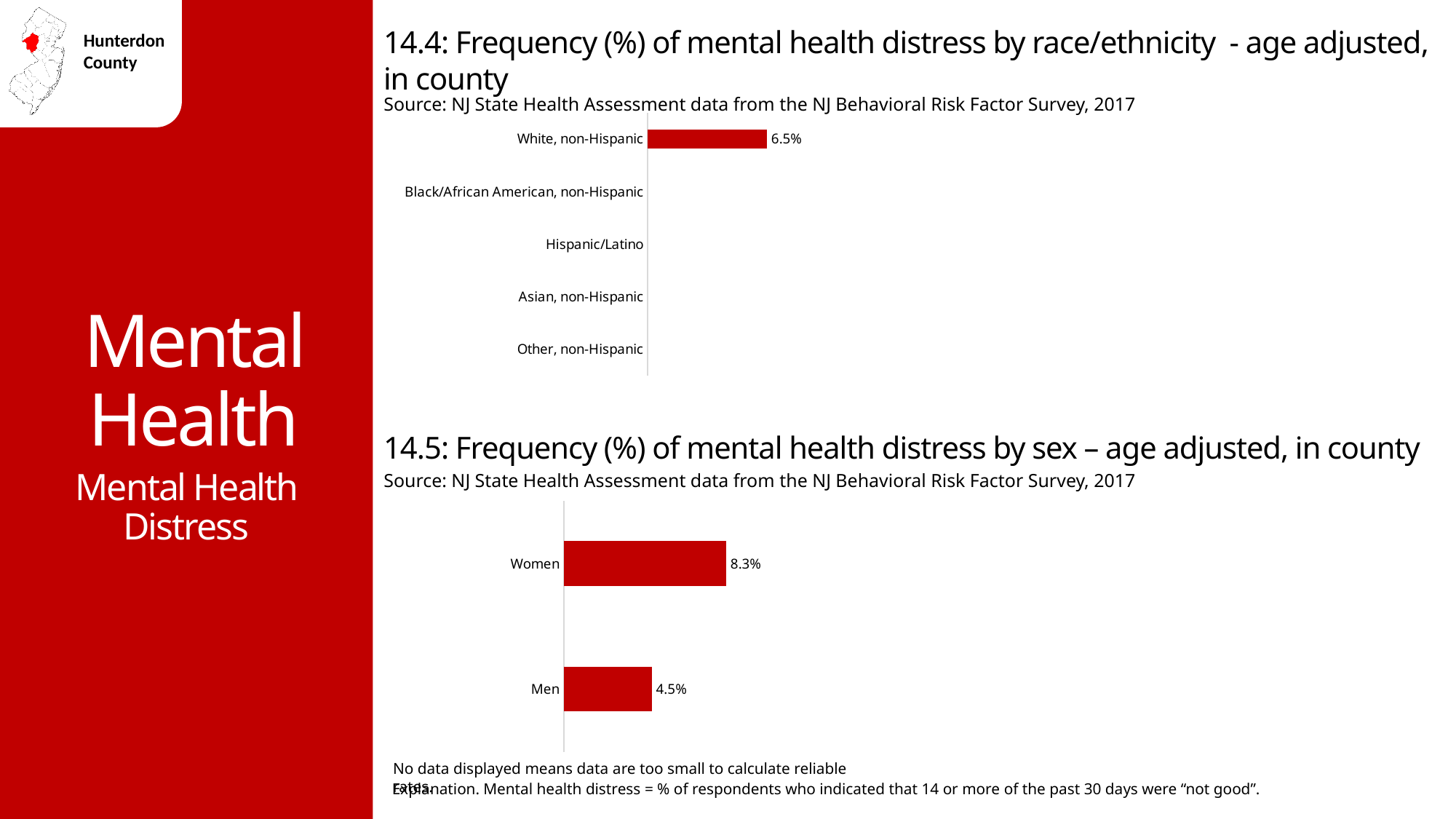
In chart 14.5 (mental health distress by sex), which category has the lowest value? Men In chart 14.5 (mental health distress by sex), what is the value for Men? 4.5% In chart 14.4 (mental health distress by race/ethnicity), how many race/ethnicity categories are listed on the axis? 5 What kind of chart is chart 14.5 (mental health distress by sex)? Bar chart In chart 14.5 (mental health distress by sex), is the value for Women or Men larger? Women In chart 14.4 (mental health distress by race/ethnicity), which category is the only one with a bar displayed? White, non-Hispanic In chart 14.5 (mental health distress by sex), how many categories are shown? 2 In chart 14.5 (mental health distress by sex), what is the value for Women? 8.3% What kind of chart is chart 14.4 (mental health distress by race/ethnicity)? Bar chart In chart 14.4 (mental health distress by race/ethnicity), what is the value for White, non-Hispanic? 6.5% In chart 14.5 (mental health distress by sex), what is the difference between the values for Women and Men? 3.8% In chart 14.5 (mental health distress by sex), which category has the highest value? Women